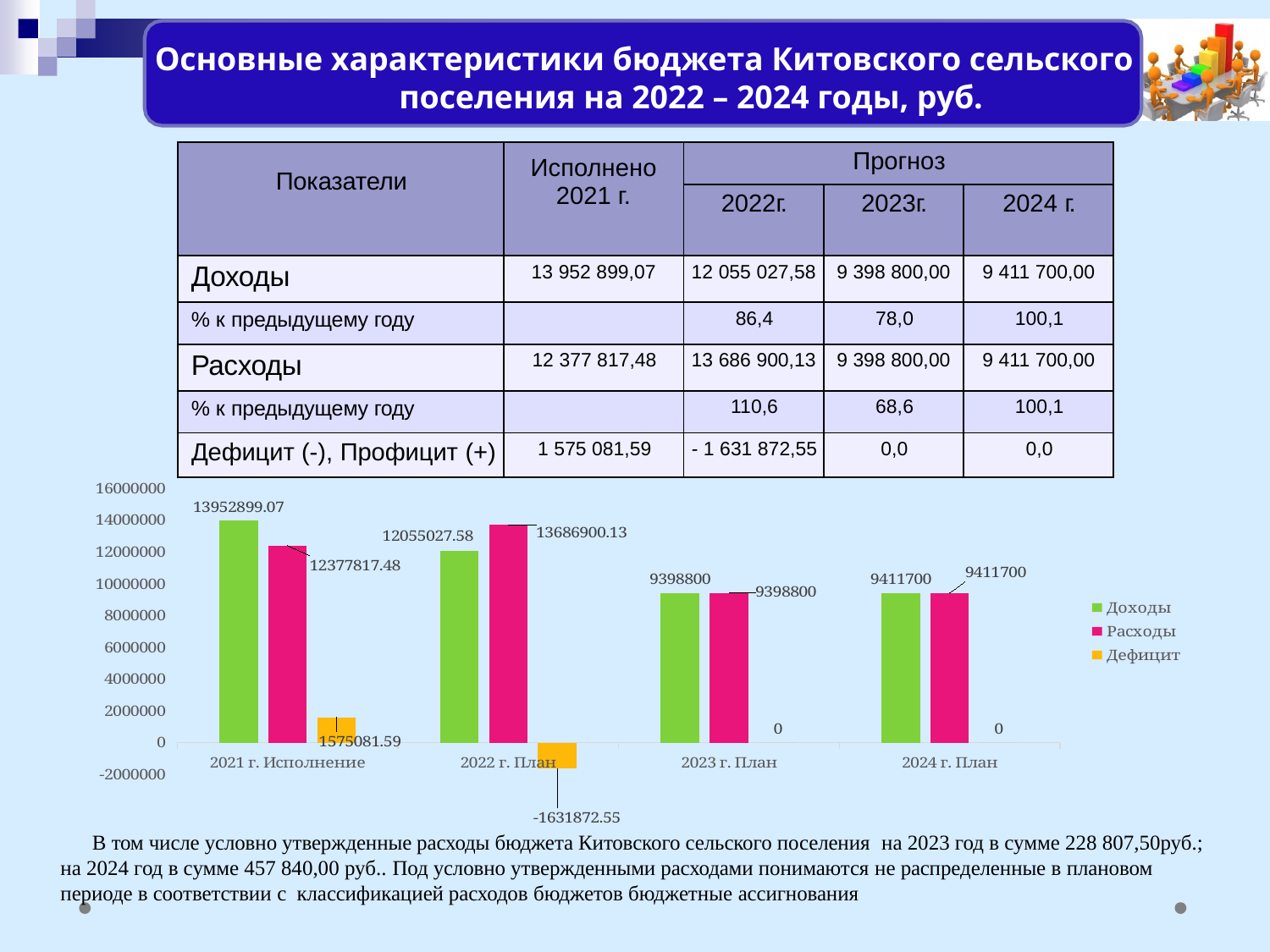
What kind of chart is shown on the slide? bar chart What is the value of Расходы for 2022 г. План in the chart? 13686900.13 What is the difference between Доходы and Расходы for 2021 г. Исполнение in the chart? 1575081.59 What is the value of Доходы for 2024 г. План in the chart? 9411700 Which is larger in the chart for 2022 г. План: Доходы or Расходы? Расходы Which series in the chart legend is shown in green? Доходы What is the value of Дефицит for 2022 г. План in the chart? -1631872.55 How many series does the chart legend list? 3 In which category is Расходы lowest in the chart? 2023 г. План In which category is Доходы highest in the chart? 2021 г. Исполнение What is the value of Доходы for 2021 г. Исполнение in the chart? 13952899.07 How many categories are shown along the x axis of the chart? 4